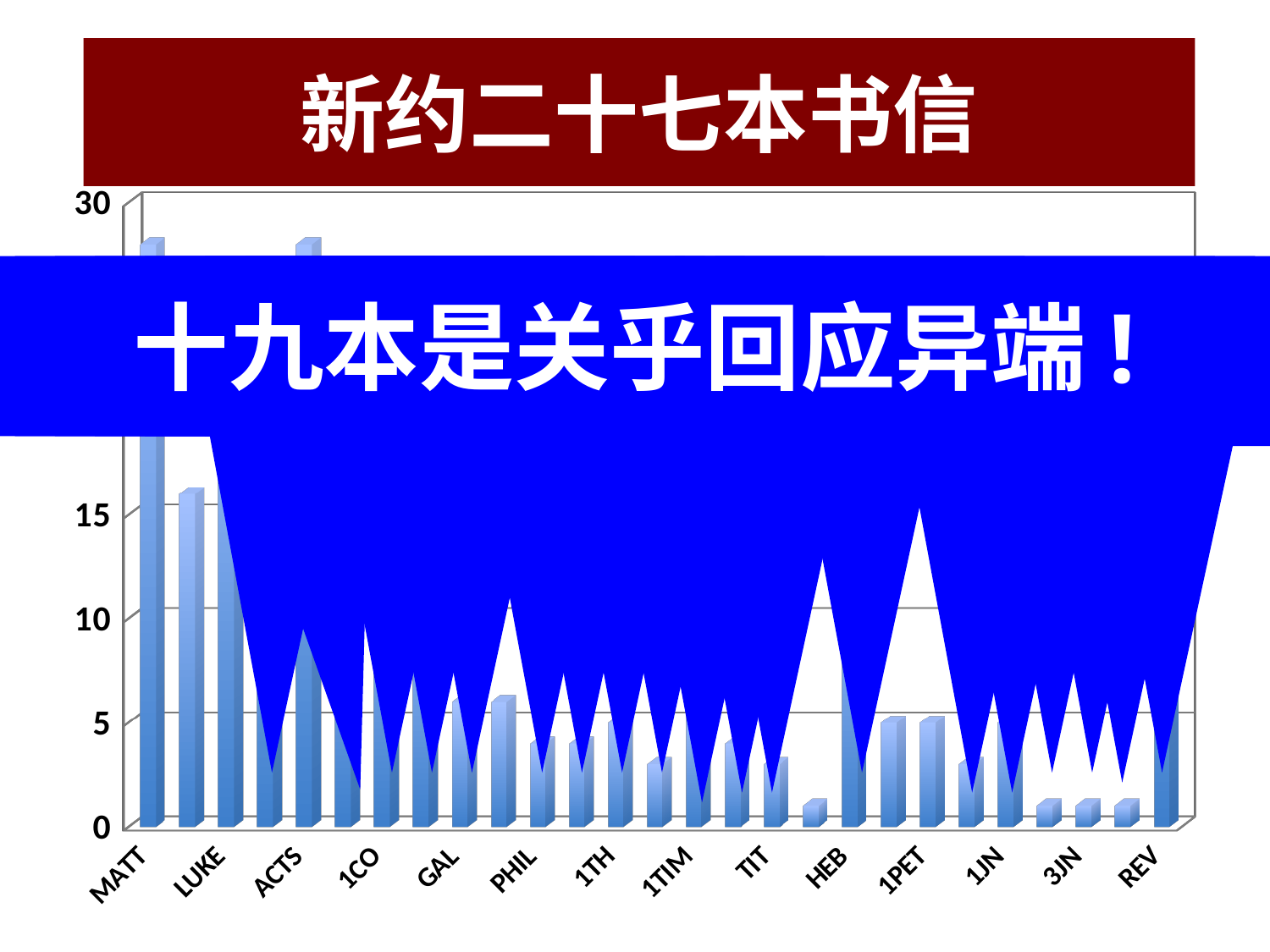
Is the value for MATT greater or less than 15? greater What is the first category label on the horizontal axis? MATT Is the value for LUKE greater or less than 10? greater Is the value for PHIL greater or less than 10? less What is the highest value shown on the vertical axis? 30 Which is larger, the value for ACTS or the value for 3JN? ACTS What kind of chart is shown on the slide? bar chart